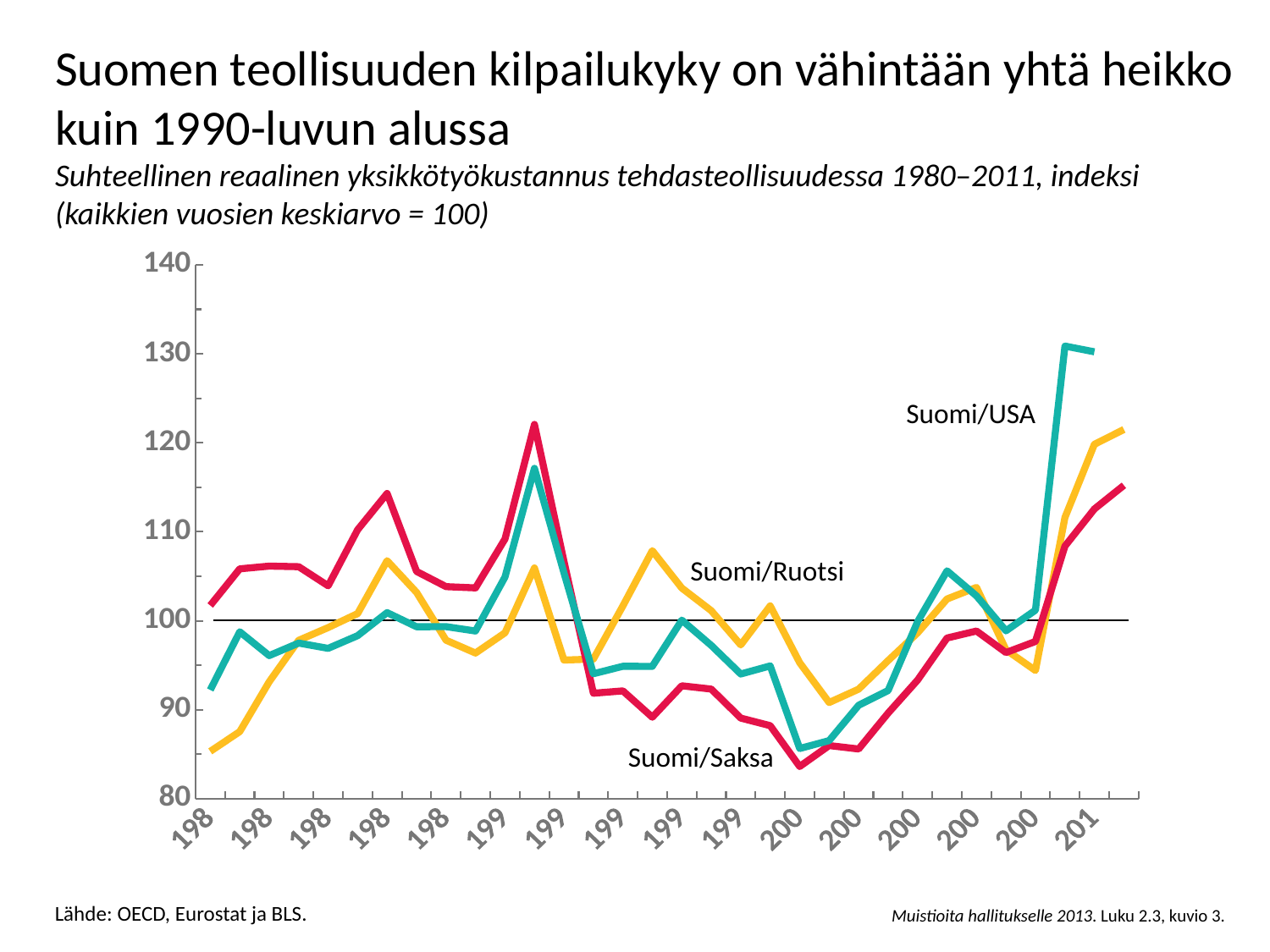
At the right end of the chart, which line is higher: Suomi/USA or Suomi/Saksa? Suomi/USA What kind of chart is shown on the slide? line chart At the right end of the chart, which line is higher: Suomi/Ruotsi or Suomi/Saksa? Suomi/Ruotsi Which series reaches the highest value anywhere on the chart? Suomi/USA Is the highest value of the Suomi/USA line greater or less than 120? greater What is the highest value shown on the vertical axis? 140 Do the three lines rise or fall over the last few points at the right end of the chart? rise At what value is the horizontal reference line drawn across the chart? 100 How many series are plotted on the chart? 3 Is the first value of the Suomi/Ruotsi line (at the left edge of the chart) greater or less than 90? less Is the final value of the Suomi/Saksa line greater or less than 110? greater